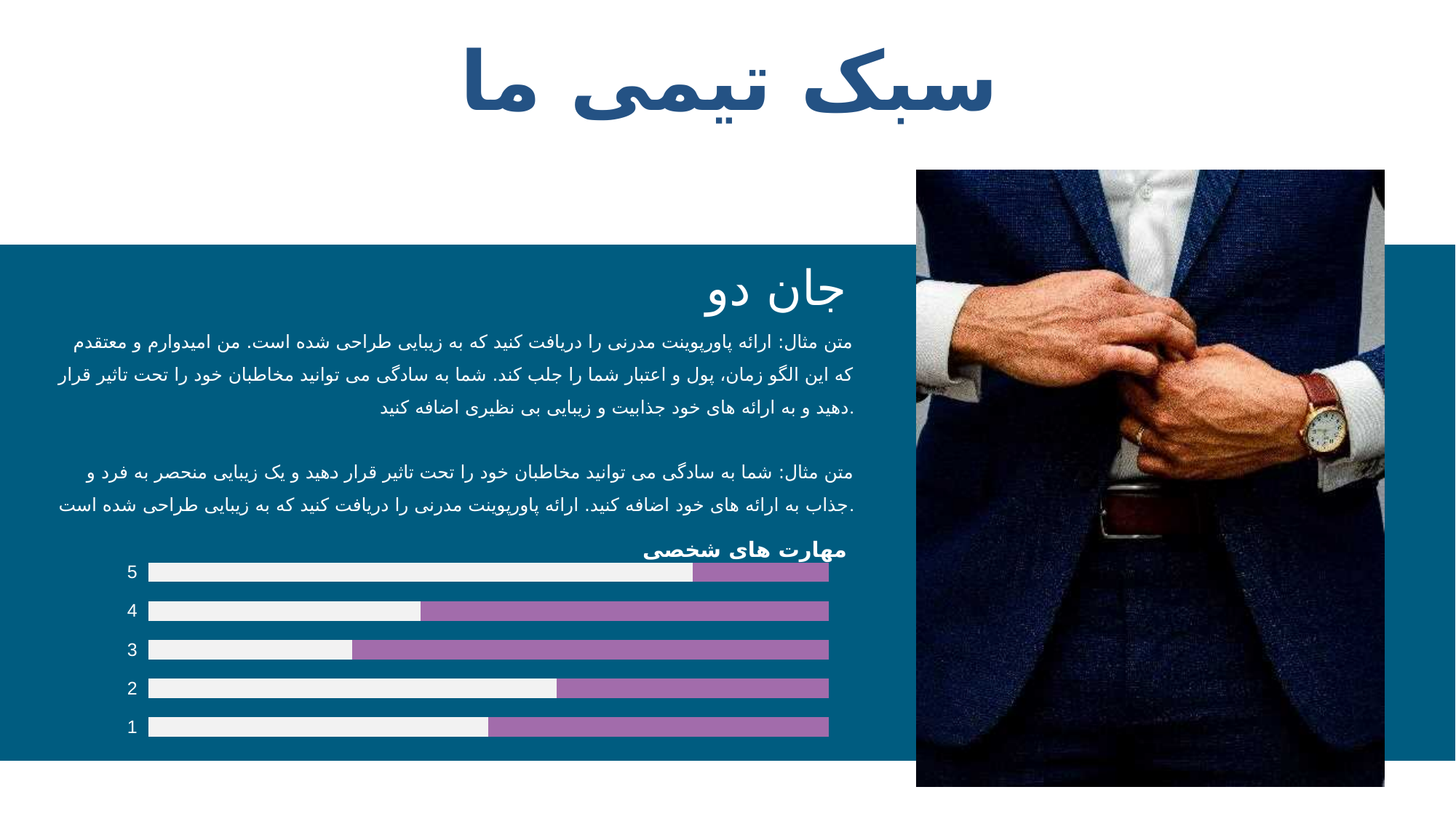
What kind of chart is shown on the slide? bar chart Is the grey segment longer for category 2 or category 4? 2 How many categories (bars) does the chart show? 5 What is the title of the chart? مهارت های شخصی Which category has the shortest grey segment? 3 Is the grey segment longer for category 1 or category 2? 2 What two colours are used for the segments of each bar? grey and purple Is the purple segment longer for category 3 or category 5? 3 Which category has the longest purple segment? 3 Which category has the shortest purple segment? 5 Which category has the longest grey segment? 5